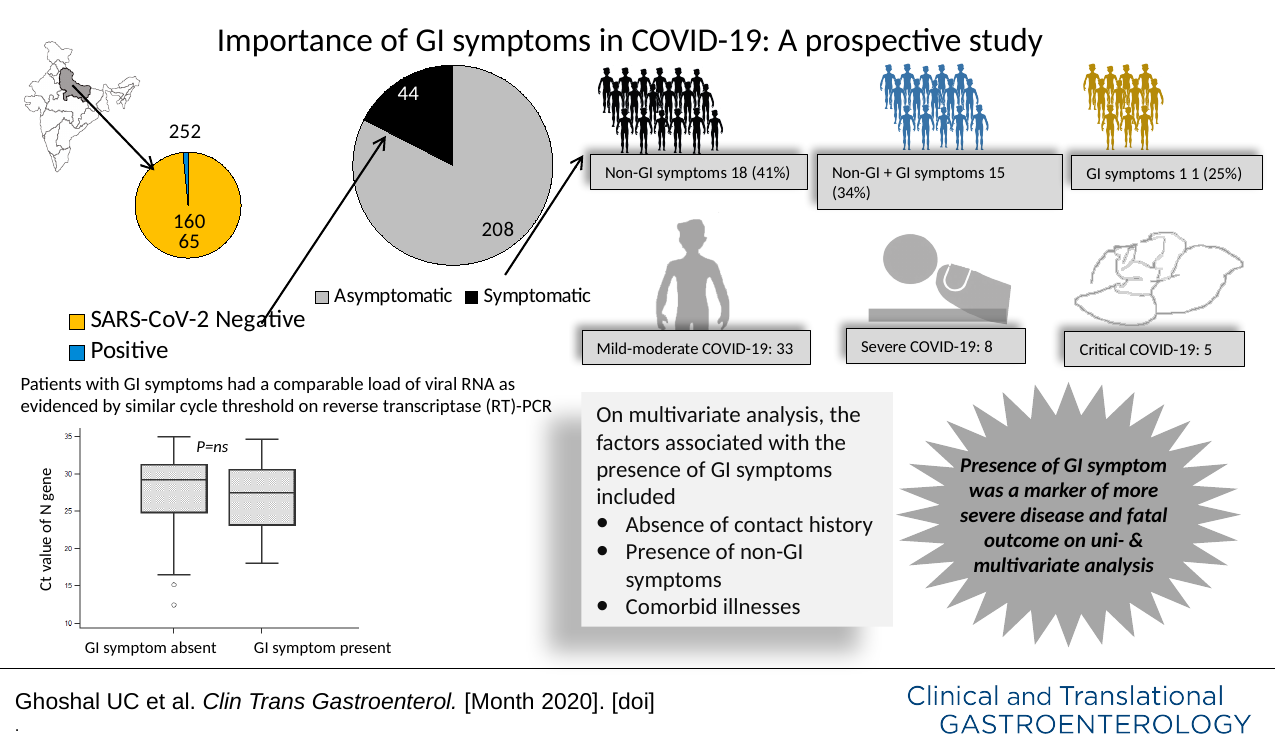
In the Ct value of N gene box plot, is the median for GI symptom absent greater or less than 25? greater What kind of chart is the SARS-CoV-2 Negative/Positive chart on the left of the slide? Pie chart In the Asymptomatic/Symptomatic pie chart, what is the difference between the Asymptomatic and Symptomatic values? 164 In the Asymptomatic/Symptomatic pie chart, what is the value for Asymptomatic? 208 In the Asymptomatic/Symptomatic pie chart, what is the value for Symptomatic? 44 How many entries does the legend of the Asymptomatic/Symptomatic pie chart list? 2 In the Asymptomatic/Symptomatic pie chart, which slice is larger? Asymptomatic In the Asymptomatic/Symptomatic pie chart, what colour is the Symptomatic slice? Black In the SARS-CoV-2 pie chart, which slice is larger, Negative or Positive? Negative How many categories are shown on the x axis of the Ct value of N gene box plot? 2 In the Asymptomatic/Symptomatic pie chart, what is the total of the two slices? 252 What kind of chart is the Ct value of N gene chart at the bottom left? Box plot